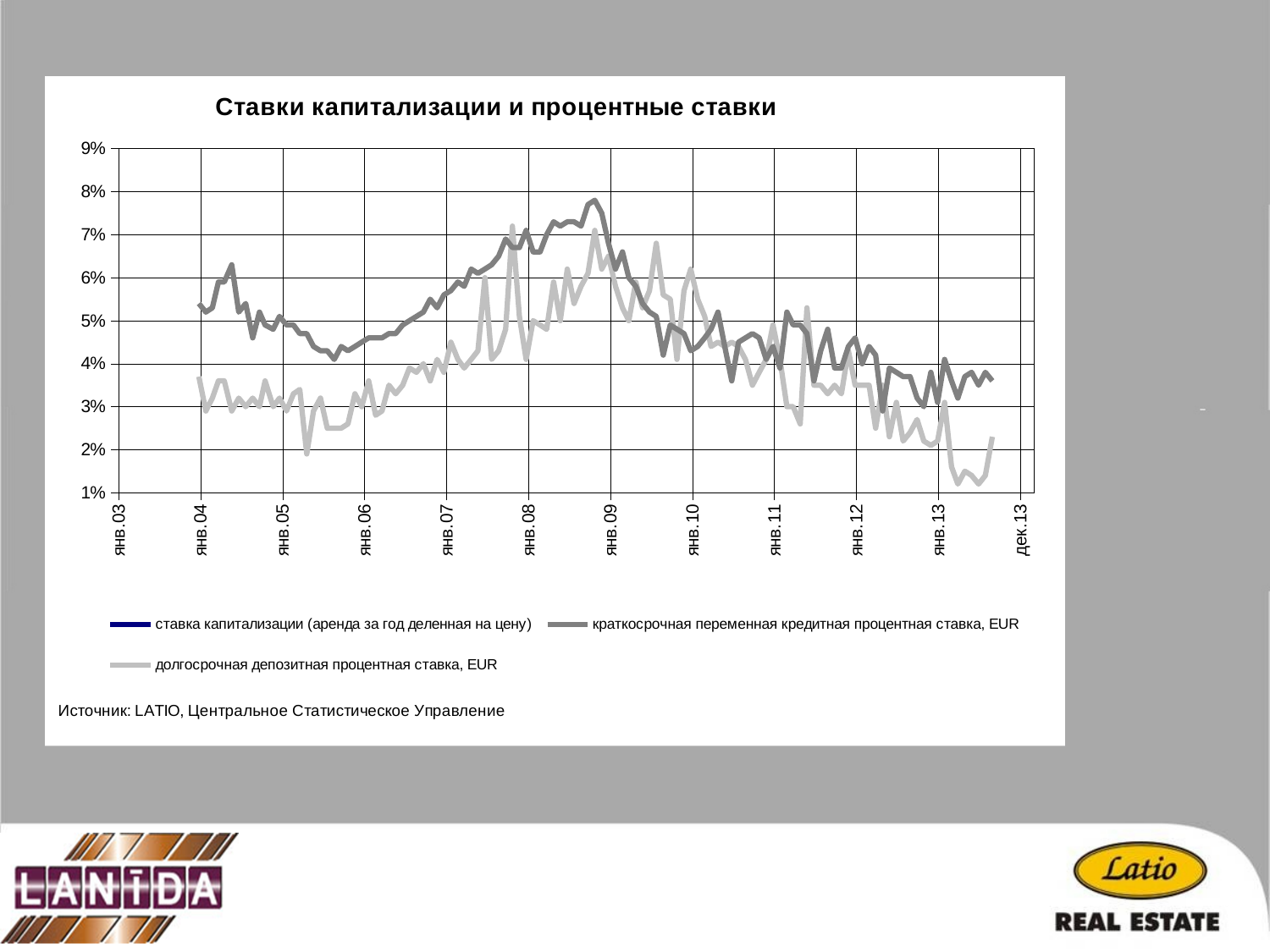
What is the last label on the horizontal axis of the chart? дек.13 How many series does the chart legend list? 3 What is the highest value shown on the vertical axis? 9% Does the light gray line (долгосрочная депозитная процентная ставка, EUR) rise or fall between янв.05 and янв.08? rise What kind of chart is shown on the slide? line chart Is the value of the light gray line (долгосрочная депозитная процентная ставка, EUR) at янв.05 greater or less than 4%? less Is the value of the dark gray line (краткосрочная переменная кредитная процентная ставка, EUR) at янв.06 greater or less than 4%? greater At янв.06, which line is higher: the dark gray line (краткосрочная переменная кредитная процентная ставка, EUR) or the light gray line (долгосрочная депозитная процентная ставка, EUR)? the dark gray line (краткосрочная переменная кредитная процентная ставка, EUR) Does the dark gray line (краткосрочная переменная кредитная процентная ставка, EUR) rise or fall between янв.09 and янв.13? fall What is the title of the chart? Ставки капитализации и процентные ставки